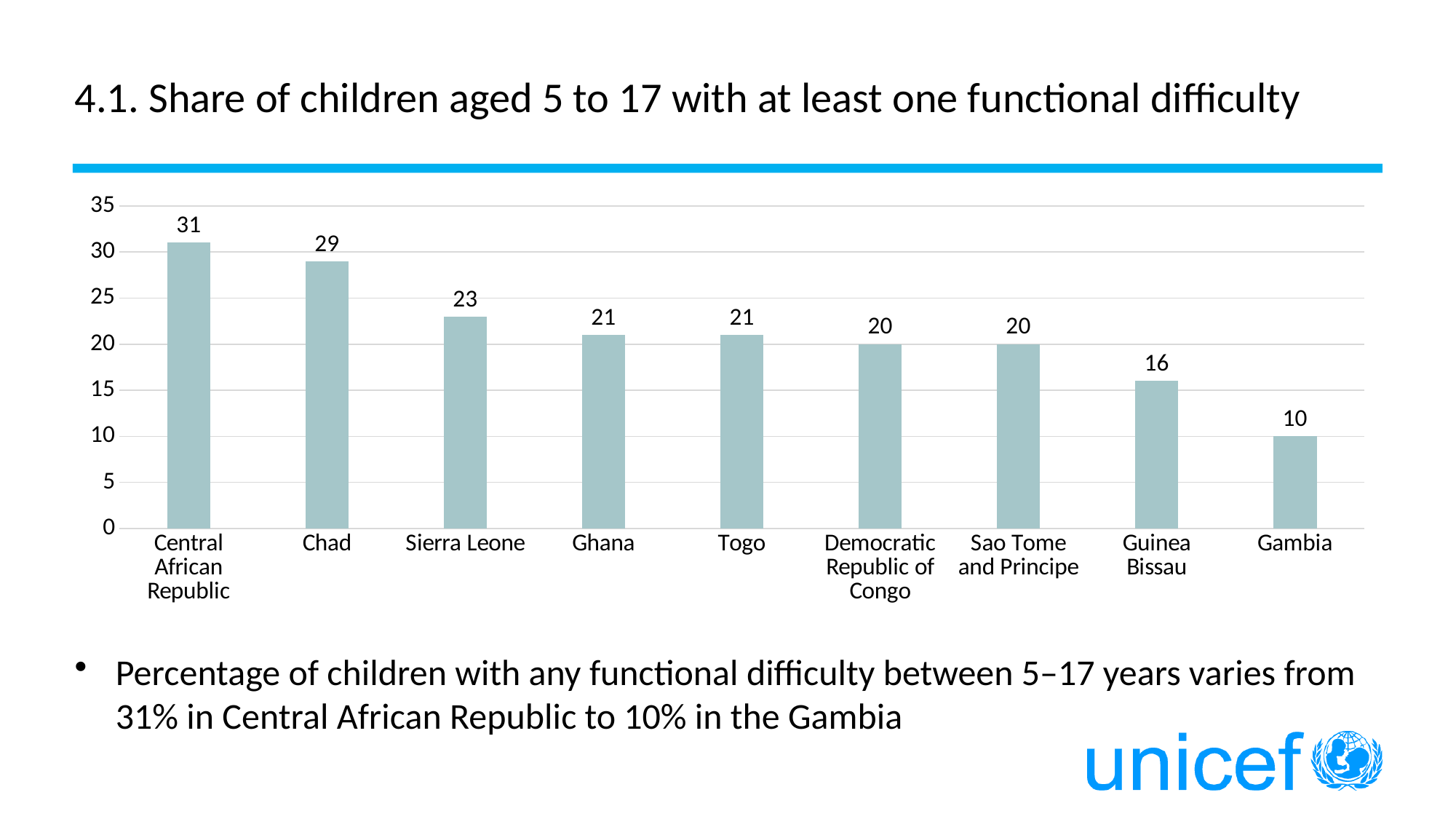
What is the value for Sierra Leone? 23 What is the difference between the values for Central African Republic and Gambia? 21 What is the difference between the values for Chad and Sierra Leone? 6 What kind of chart is shown on the slide? bar chart How many countries are shown in the chart? 9 Is the value for Sao Tome and Principe greater or less than 25? less Which country has the lowest value? Gambia Which country has the highest value? Central African Republic What is the value for Guinea Bissau? 16 What is the value for Chad? 29 Which is larger, the value for Ghana or the value for Guinea Bissau? Ghana Do the values rise or fall from left to right across the chart? fall